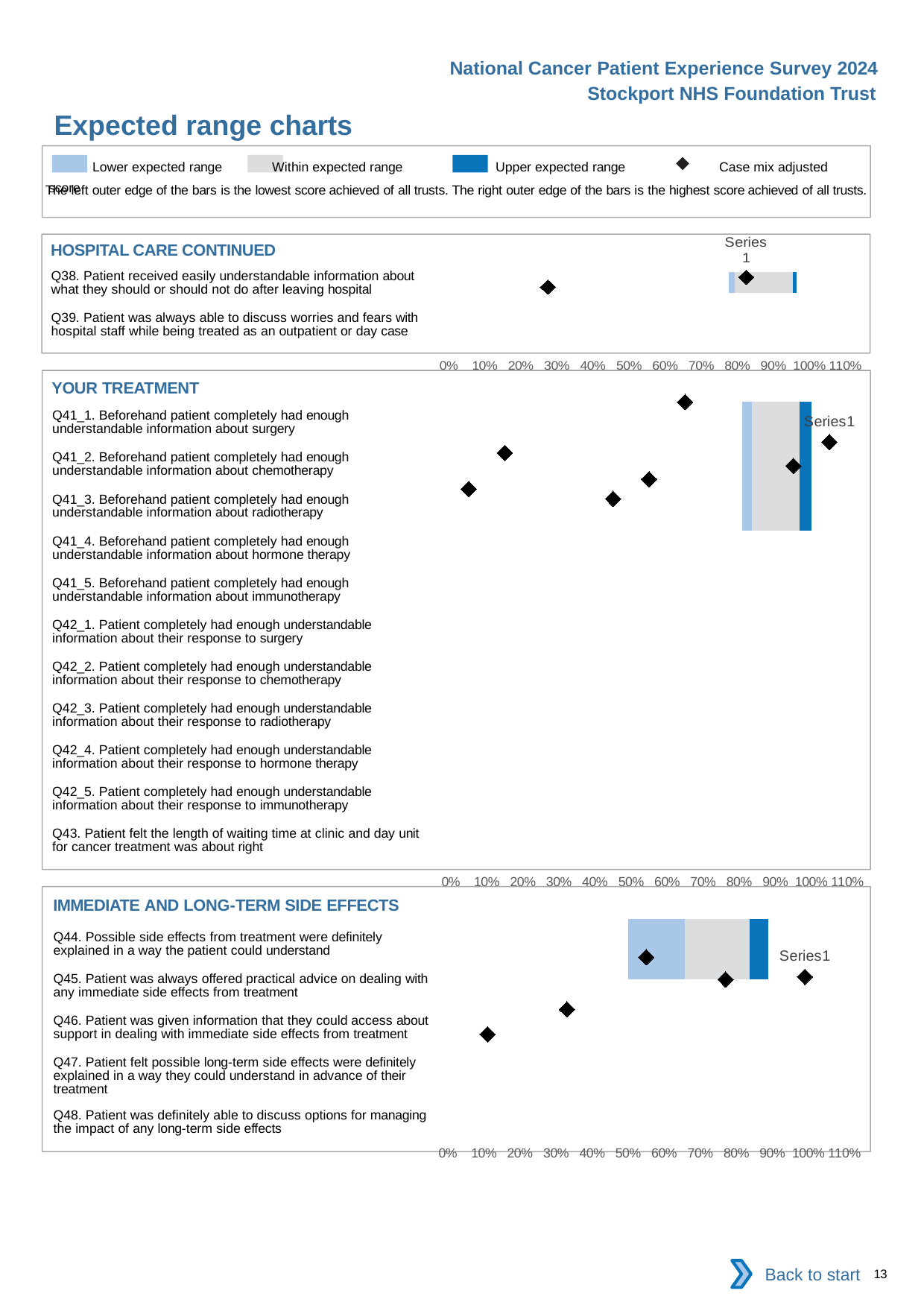
How many diamond markers are plotted in the IMMEDIATE AND LONG-TERM SIDE EFFECTS chart? 5 How many diamond markers are plotted in the HOSPITAL CARE CONTINUED chart? 2 How many question categories are listed in the HOSPITAL CARE CONTINUED chart? 2 What is the title of the slide containing these charts? Expected range charts What kind of chart is used in the YOUR TREATMENT section? Bar chart with diamond markers What is the lowest tick label on the x axis of the IMMEDIATE AND LONG-TERM SIDE EFFECTS chart? 0% What is the highest tick label on the x axis of the YOUR TREATMENT chart? 110% What are the four legend entries shown at the top of the slide? Lower expected range, Within expected range, Upper expected range, Case mix adjusted score